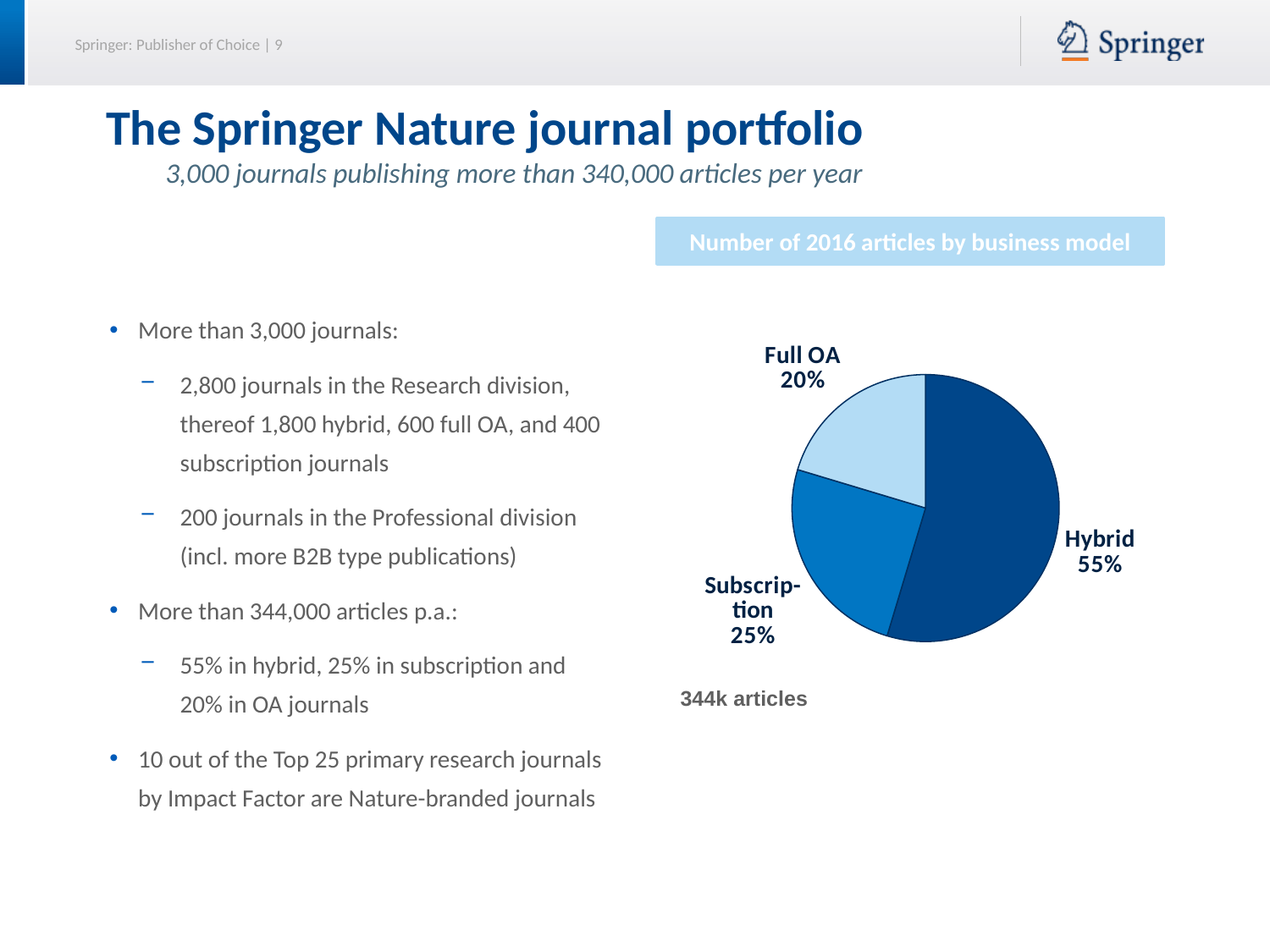
What is the difference in percentage points between the Hybrid and Subscription shares? 30 Which business model has the largest share of 2016 articles? Hybrid What kind of chart is shown on the slide? pie chart What share of 2016 articles is in the Full OA business model? 20% Which business model has the smallest share of 2016 articles? Full OA What share of 2016 articles is in the Subscription business model? 25% What is the title of the chart? Number of 2016 articles by business model What total number of articles is noted below the pie chart? 344k articles Which has a larger share of 2016 articles, Subscription or Full OA? Subscription What is the difference in percentage points between the Subscription and Full OA shares? 5 How many slices does the pie chart have? 3 What share of 2016 articles is in the Hybrid business model? 55%